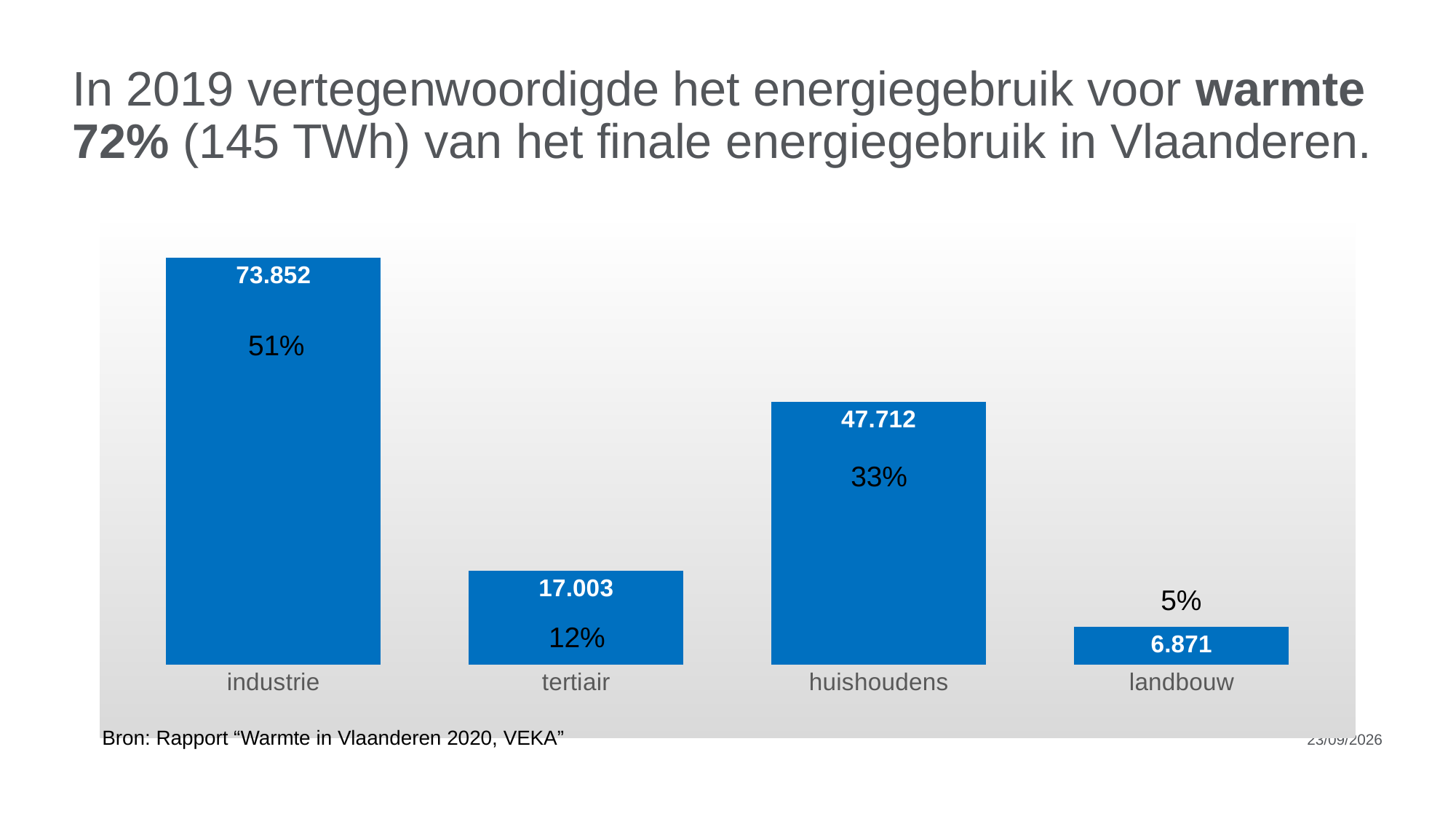
Which category has the lowest value? landbouw What is the difference between the values for tertiair and landbouw? 10.132 What percentage is shown for tertiair? 12% Which category has the highest value? industrie How many categories are shown in the chart? 4 What kind of chart is shown on the slide? bar chart What is the value shown for huishoudens? 47.712 What is the value shown for industrie? 73.852 What is the value shown for landbouw? 6.871 Which is larger, the value for tertiair or the value for huishoudens? huishoudens What is the difference between the values for industrie and huishoudens? 26.140 What percentage share is shown for huishoudens? 33%